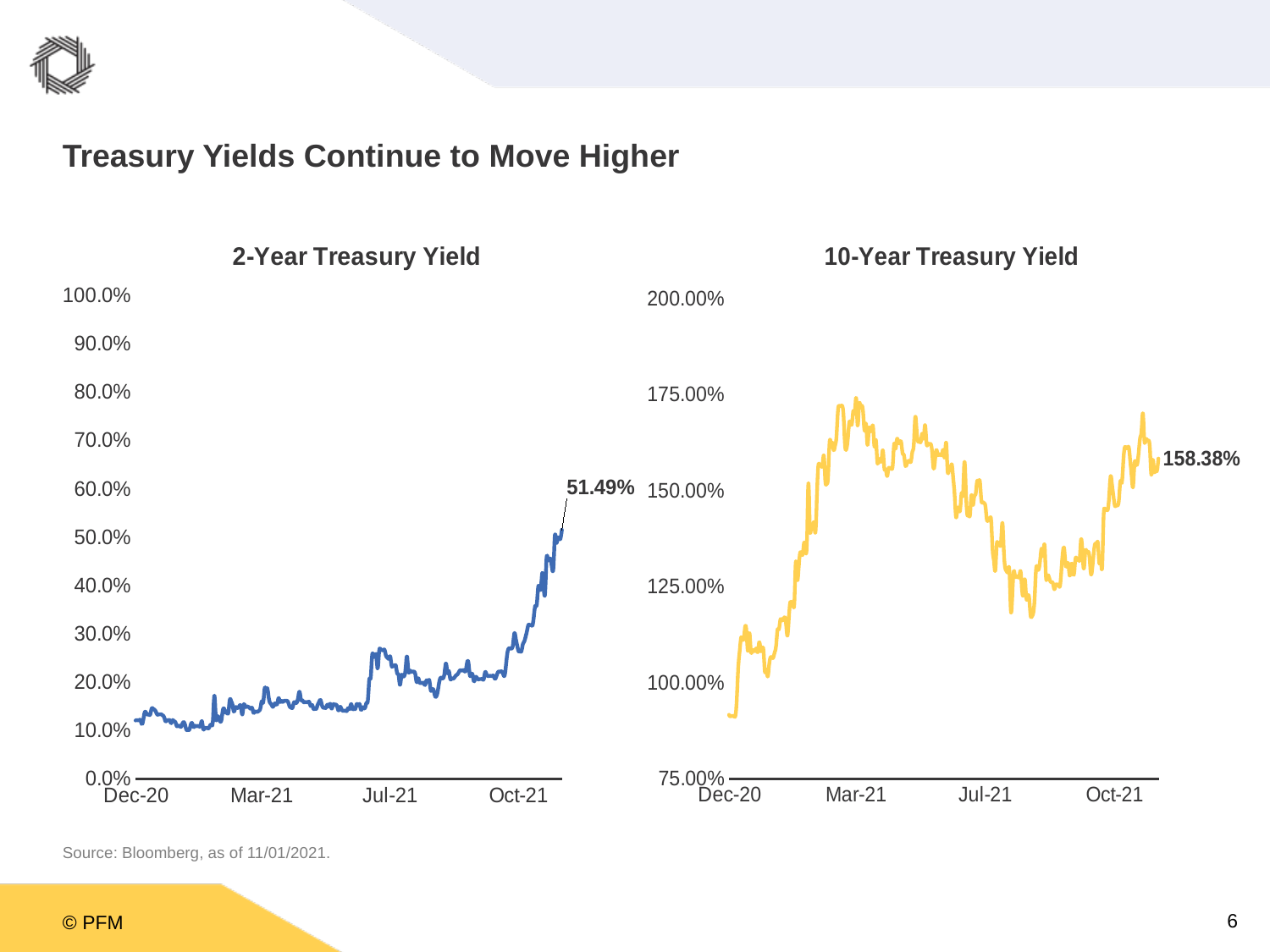
In the 2-Year Treasury Yield chart, is the value around Jul-21 greater or less than 40.0%? less What is the maximum value shown on the y-axis of the 10-Year Treasury Yield chart? 200.00% In the 10-Year Treasury Yield chart, is the value around Jul-21 greater or less than 150.00%? less In the 2-Year Treasury Yield chart, what is the labeled value at the end of the line? 51.49% What type of chart is the 2-Year Treasury Yield chart? Line chart What type of chart is the 10-Year Treasury Yield chart? Line chart In the 10-Year Treasury Yield chart, is the value around Mar-21 greater or less than 150.00%? greater What is the title of the slide containing the two charts? Treasury Yields Continue to Move Higher In the 2-Year Treasury Yield chart, does the line generally rise or fall from Dec-20 to Oct-21? Rise In the 10-Year Treasury Yield chart, what is the labeled value at the end of the line? 158.38%